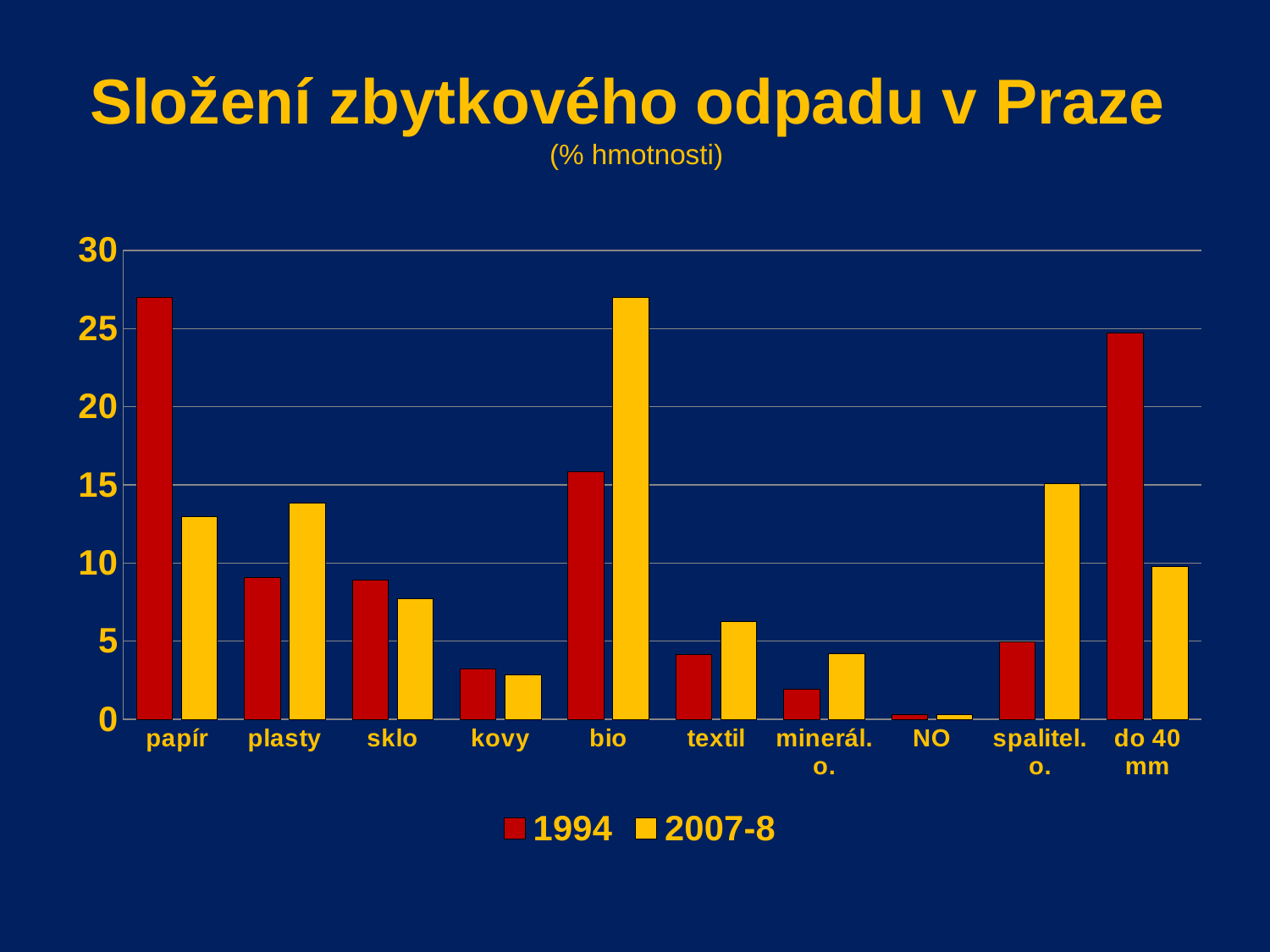
Is the 2007-8 value for bio greater or less than 25? greater For spalitel. o., which series has the larger value, 1994 or 2007-8? 2007-8 How many categories are shown on the x axis? 10 Which colour represents the 1994 series in the legend? red For papír, which series has the larger value, 1994 or 2007-8? 1994 How many series does the legend list? 2 Which category has the lowest value for the 1994 series? NO Is the 1994 value for do 40 mm greater or less than 20? greater What kind of chart is shown on the slide? bar chart Which category has the highest value for the 1994 series? papír Is the 1994 value for minerál. o. greater or less than 5? less Which category has the highest value for the 2007-8 series? bio